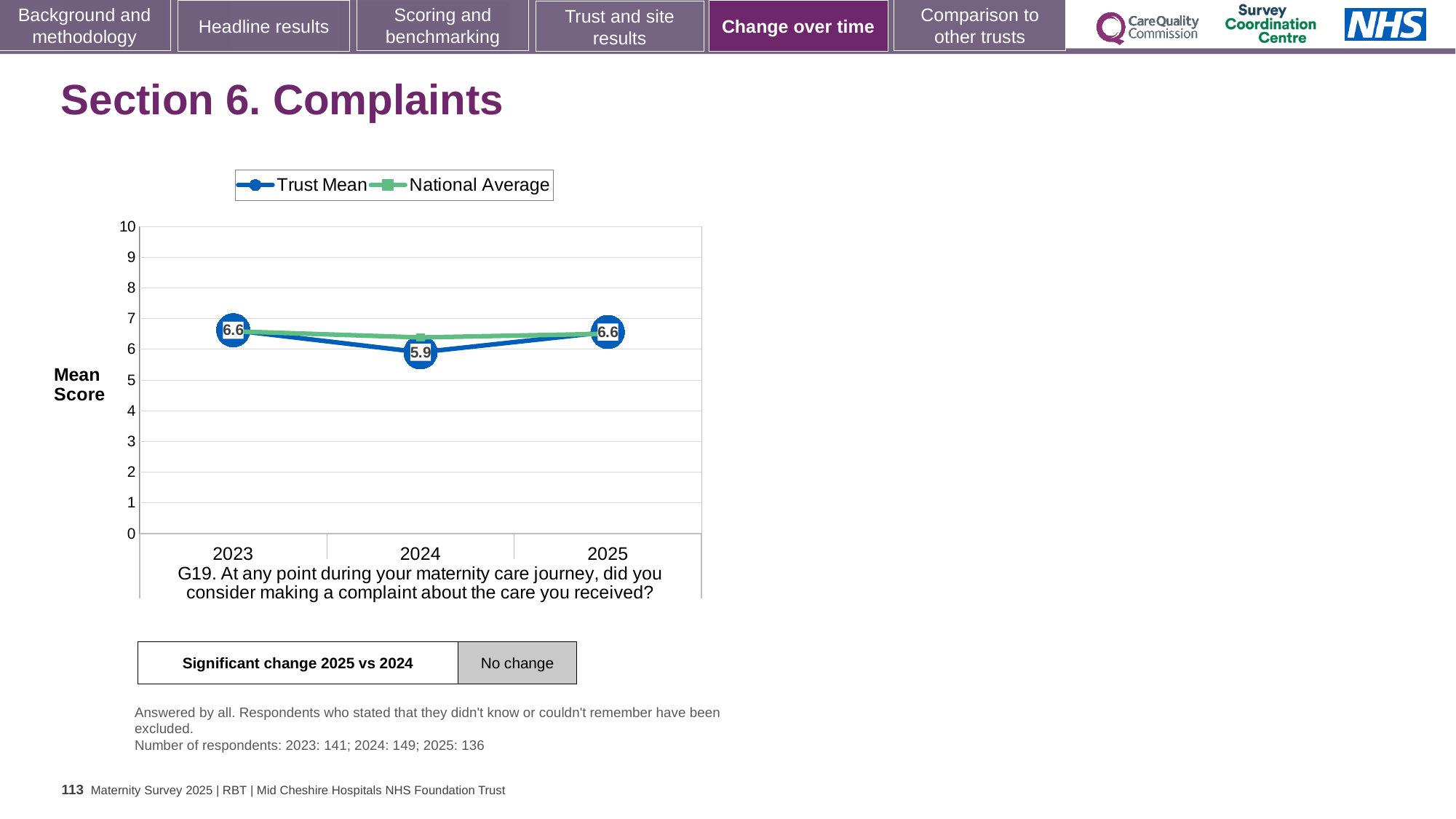
Does the Trust Mean rise or fall from 2024 to 2025? rise Is the National Average value for 2024 greater or less than 5? greater In which year is the Trust Mean lowest? 2024 How many series does the legend list? 2 What kind of chart is shown on the slide? line chart In 2024, which is larger: the Trust Mean or the National Average? National Average What is the label on the y axis of the chart? Mean Score What is the Trust Mean value for 2023? 6.6 What is the Trust Mean value for 2024? 5.9 How many years are plotted on the x axis? 3 What is the difference between the Trust Mean in 2023 and in 2024? 0.7 What is the Trust Mean value for 2025? 6.6